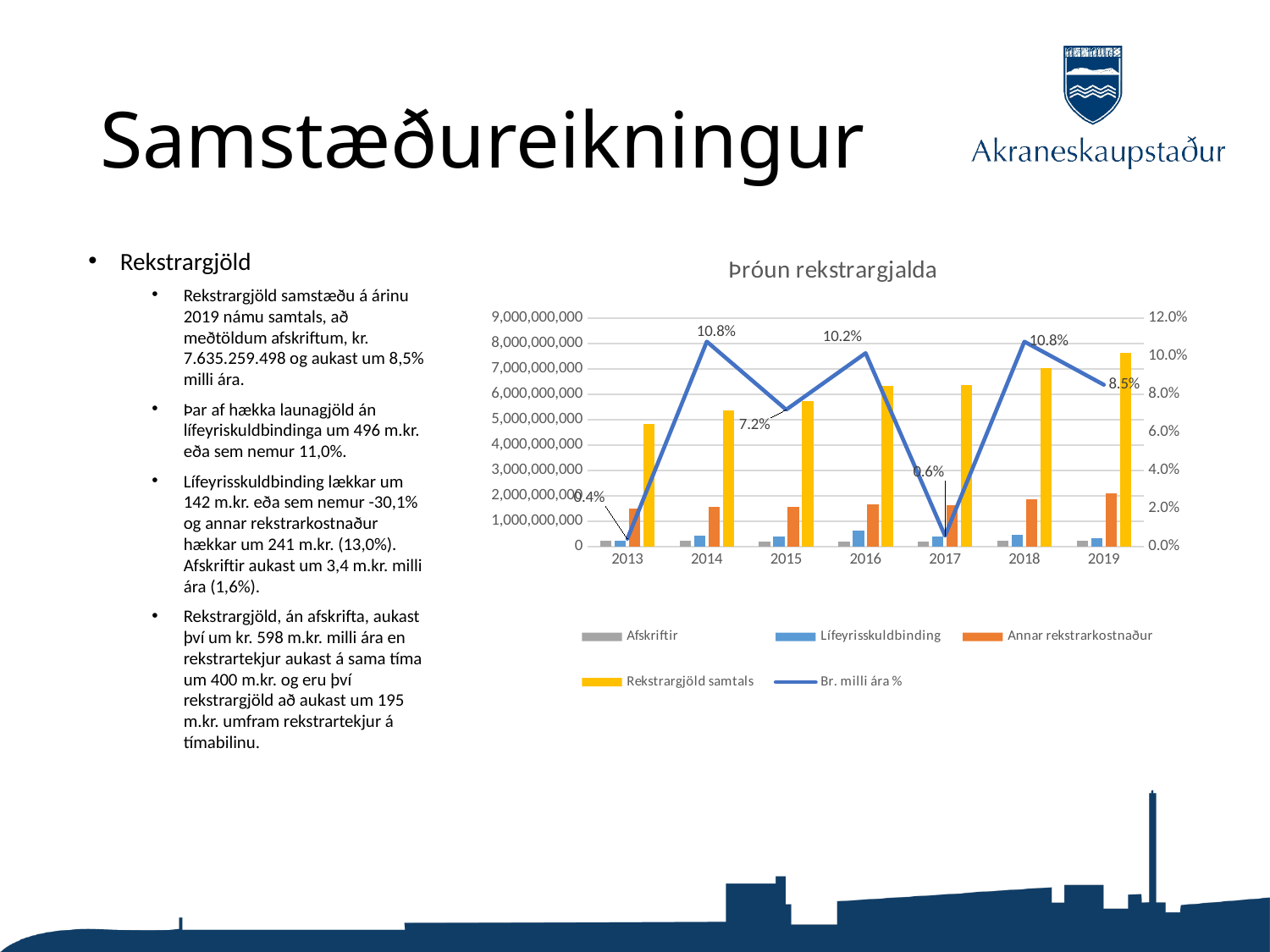
Which year has the lowest Br. milli ára % value? 2013 What kind of chart is shown on the slide? Combination bar and line chart How many years are shown on the x axis of the chart? 7 Which year has the highest Rekstrargjöld samtals bar? 2019 Which year has the larger Br. milli ára % value, 2014 or 2015? 2014 How many series does the chart legend list? 5 What is the value of Br. milli ára % for 2013? 0.4% Is the Rekstrargjöld samtals value for 2019 greater or less than 7,000,000,000? greater What is the value of Br. milli ára % for 2015? 7.2% What is the difference between the Br. milli ára % values for 2016 and 2017? 9.6 percentage points Is the Rekstrargjöld samtals value for 2013 greater or less than 5,000,000,000? less What is the value of Br. milli ára % for 2019? 8.5%